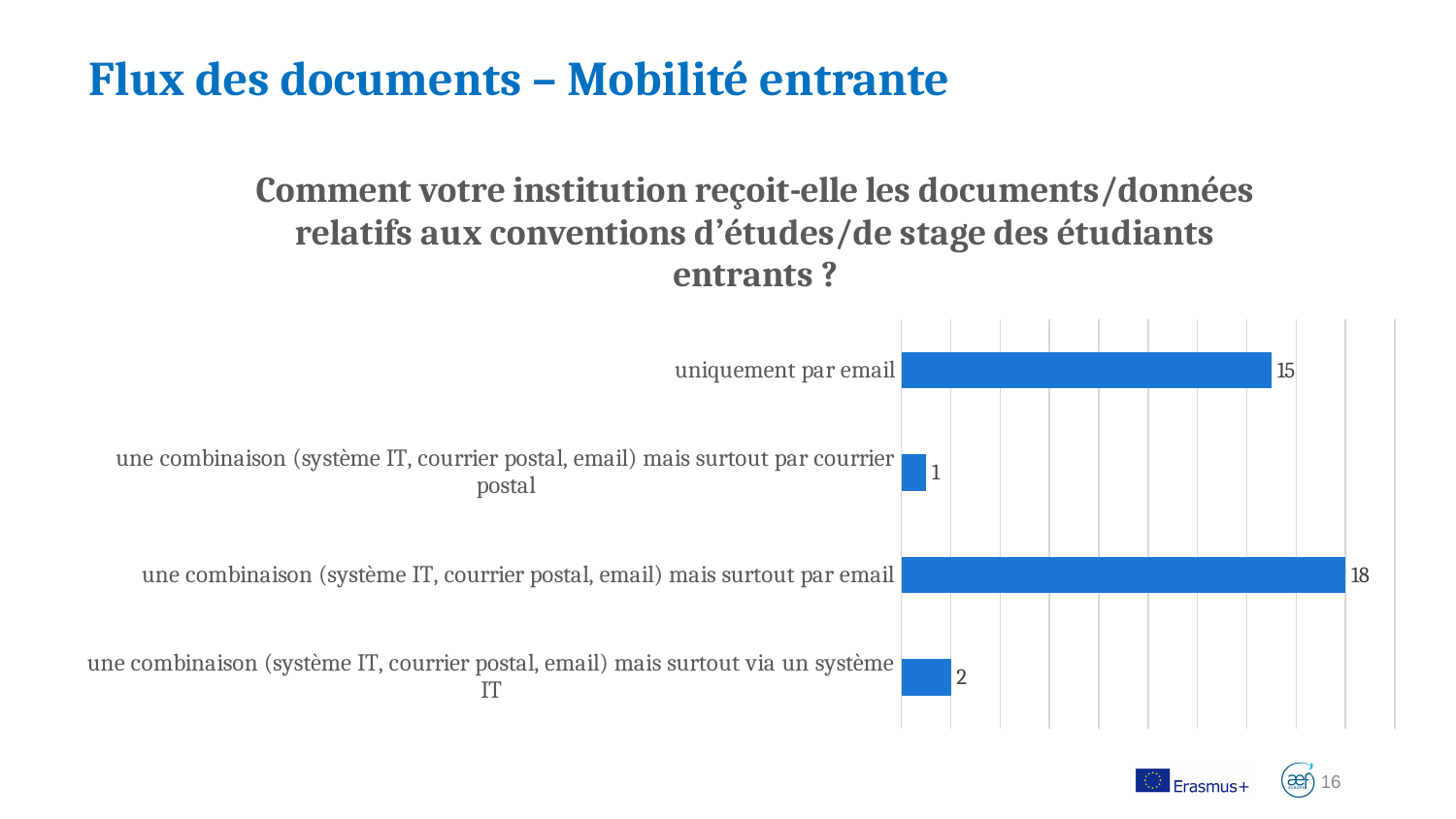
Which category has the lowest value? une combinaison (système IT, courrier postal, email) mais surtout par courrier postal What is the difference between the value for "une combinaison ... mais surtout par email" and the value for "uniquement par email"? 3 How many categories are shown in the chart? 4 What is the value for "une combinaison (système IT, courrier postal, email) mais surtout via un système IT"? 2 What is the value for "uniquement par email"? 15 What is the value for "une combinaison (système IT, courrier postal, email) mais surtout par courrier postal"? 1 Which category has the highest value? une combinaison (système IT, courrier postal, email) mais surtout par email What is the value for "une combinaison (système IT, courrier postal, email) mais surtout par email"? 18 What is the title of the chart? Comment votre institution reçoit-elle les documents/données relatifs aux conventions d'études/de stage des étudiants entrants ? What kind of chart is shown on the slide? bar chart What is the total of all four values shown in the chart? 36 Which is larger: the value for "uniquement par email" or the value for "une combinaison ... mais surtout via un système IT"? uniquement par email